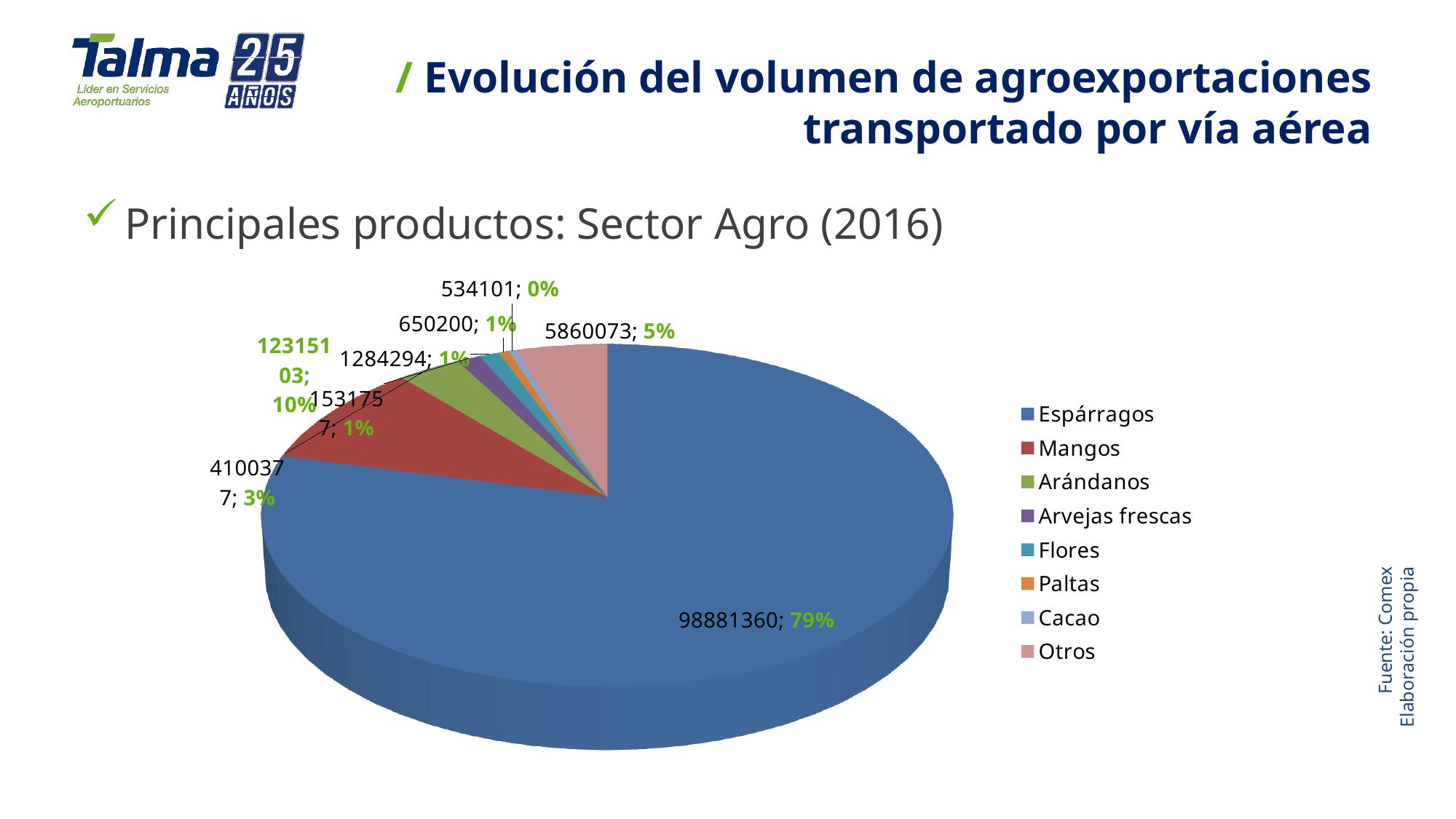
Which category has the largest slice of the pie? Espárragos What is the value shown for Espárragos? 98881360 What share of the pie does Otros represent? 5% What kind of chart is shown on the slide? Pie chart What share of the pie does Mangos represent? 10% What is the difference between the value for Paltas and the value for Cacao? 116099 Which category has the smallest slice of the pie? Cacao What is the value shown for Otros? 5860073 Which is larger, the value for Paltas or the value for Cacao? Paltas What share of the pie does Espárragos represent? 79% How many entries does the legend list? 8 How many categories does the pie chart show? 8